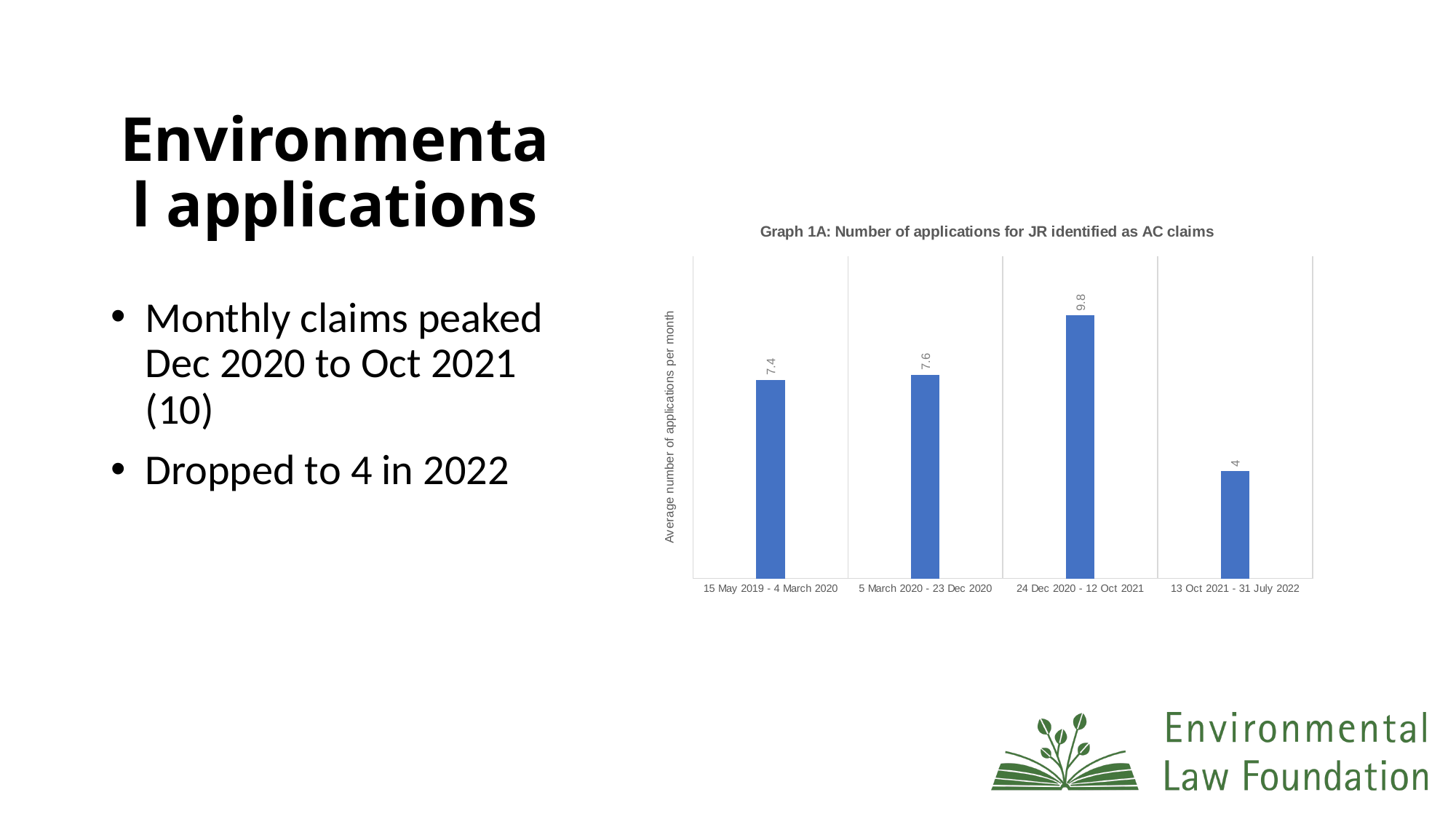
What is the average number of applications per month for the period 13 Oct 2021 - 31 July 2022? 4 What is the title of the chart? Graph 1A: Number of applications for JR identified as AC claims What is the average number of applications per month for the period 24 Dec 2020 - 12 Oct 2021? 9.8 Which period has the highest average number of applications per month? 24 Dec 2020 - 12 Oct 2021 How many periods are shown in the chart? 4 What is the average number of applications per month for the period 15 May 2019 - 4 March 2020? 7.4 Which period has the lowest average number of applications per month? 13 Oct 2021 - 31 July 2022 What kind of chart is shown on the slide? Bar chart What is the average number of applications per month for the period 5 March 2020 - 23 Dec 2020? 7.6 Which period has a larger value: 24 Dec 2020 - 12 Oct 2021 or 15 May 2019 - 4 March 2020? 24 Dec 2020 - 12 Oct 2021 What is the difference between the values for 5 March 2020 - 23 Dec 2020 and 15 May 2019 - 4 March 2020? 0.2 What is the difference between the values for 24 Dec 2020 - 12 Oct 2021 and 13 Oct 2021 - 31 July 2022? 5.8